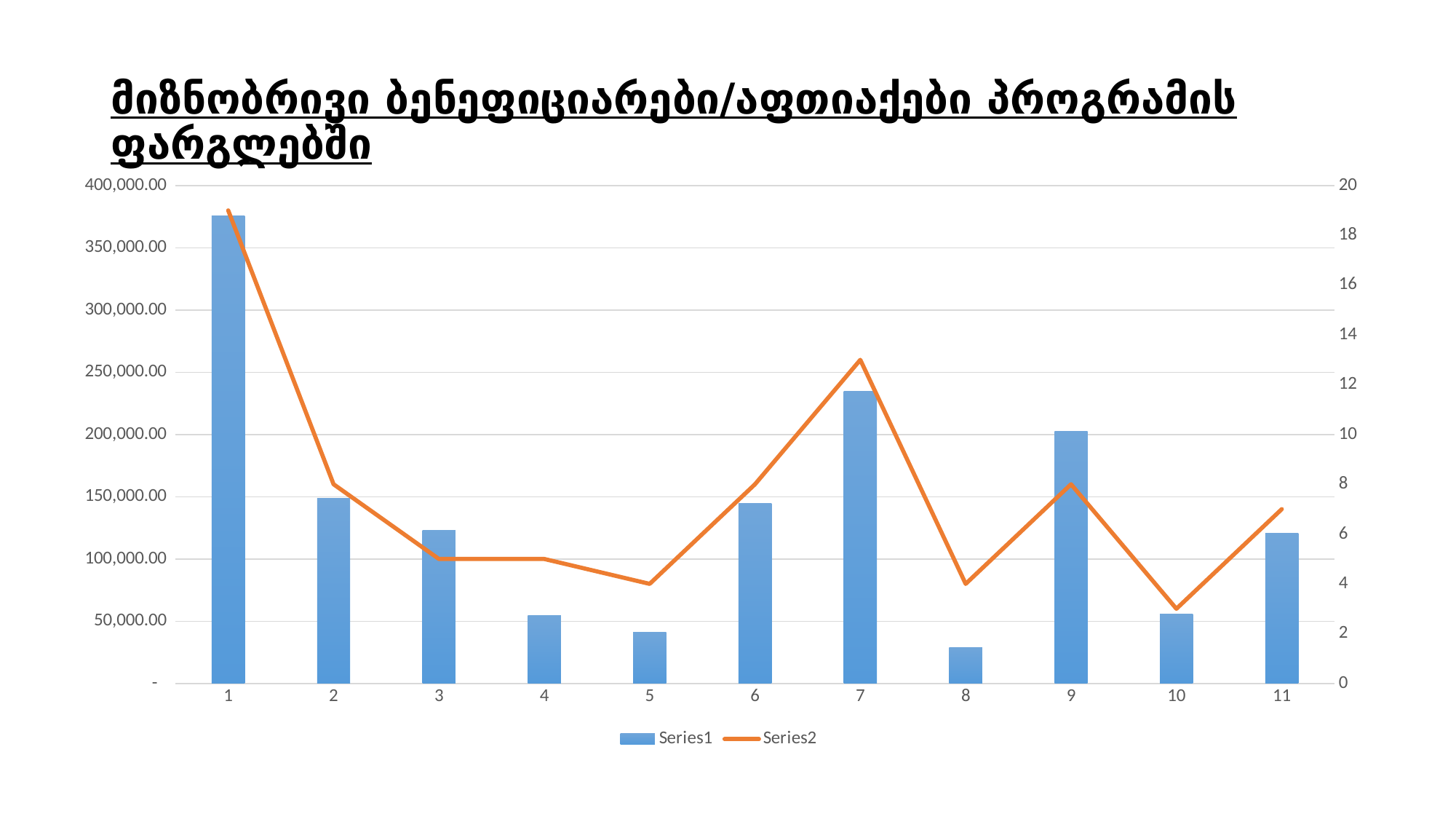
Is the Series1 value for category 8 greater or less than 50,000.00? less Which category has the lowest Series2 value? 10 How many series does the legend list? 2 What kind of chart is shown on the slide? A combination bar and line chart Which category has the highest Series1 bar? 1 Which category has the lowest Series1 bar? 8 Which has the larger Series1 bar, category 7 or category 9? Category 7 Is the Series1 value for category 1 greater or less than 350,000.00? greater How many categories are shown on the x axis? 11 Which category has the highest Series2 value? 1 Do the Series1 bars rise or fall from category 1 to category 5? fall What colour is the Series2 line? Orange